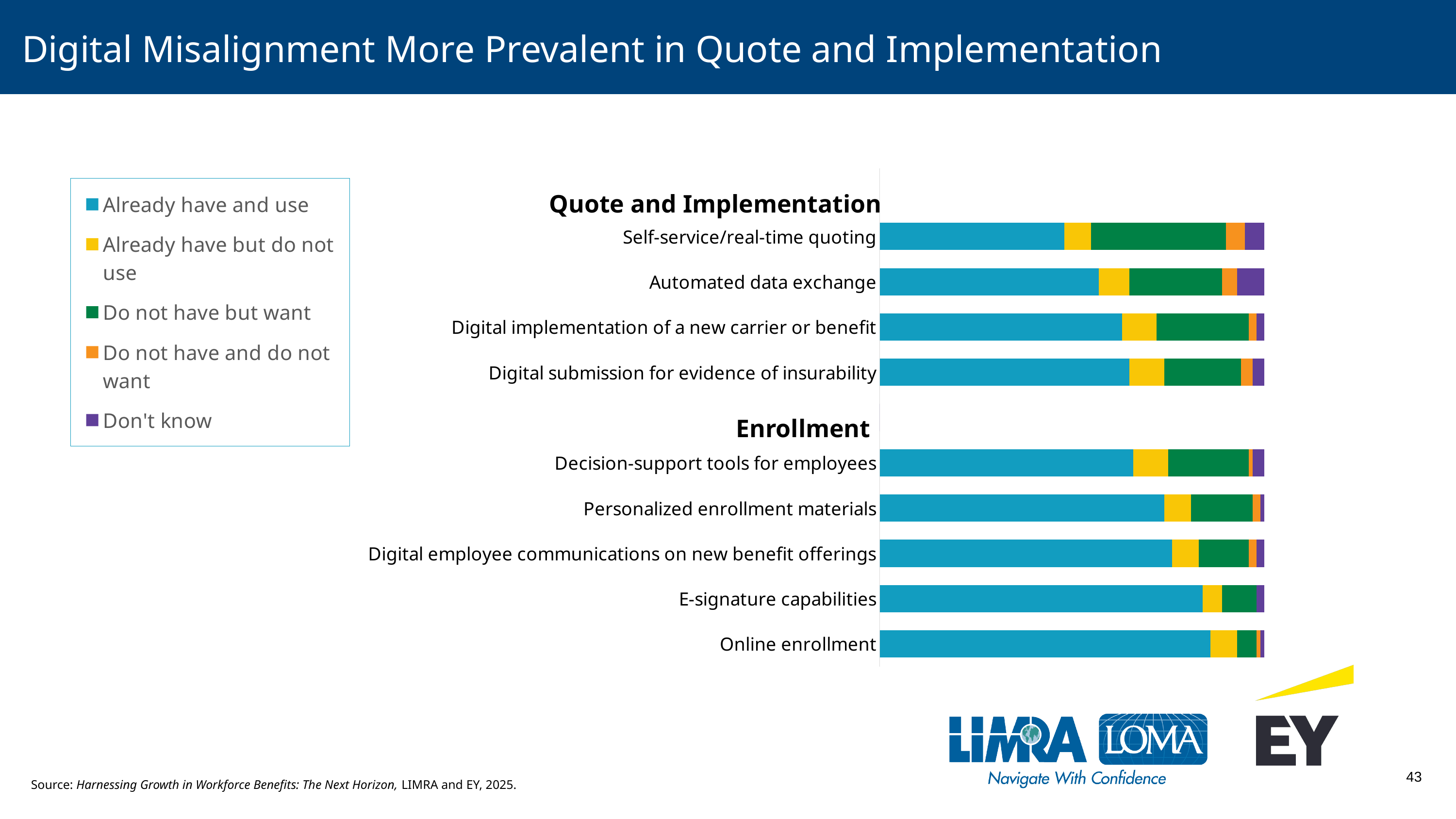
What kind of chart is shown on the slide? Stacked bar chart Which has a larger 'Already have and use' segment: E-signature capabilities or Automated data exchange? E-signature capabilities How many capabilities are listed under the Enrollment group? 5 Which capability has the largest 'Do not have but want' segment? Self-service/real-time quoting Which capability has the largest 'Don't know' segment? Automated data exchange How many capabilities are listed under the Quote and Implementation group? 4 What are the two group headings shown in the chart? Quote and Implementation; Enrollment Which colour represents 'Do not have but want' in the legend? Green How many capabilities (bars) are plotted in the chart? 9 Which capability has the largest 'Already have and use' segment? Online enrollment How many series does the legend list? 5 Which capability has the smallest 'Already have and use' segment? Self-service/real-time quoting